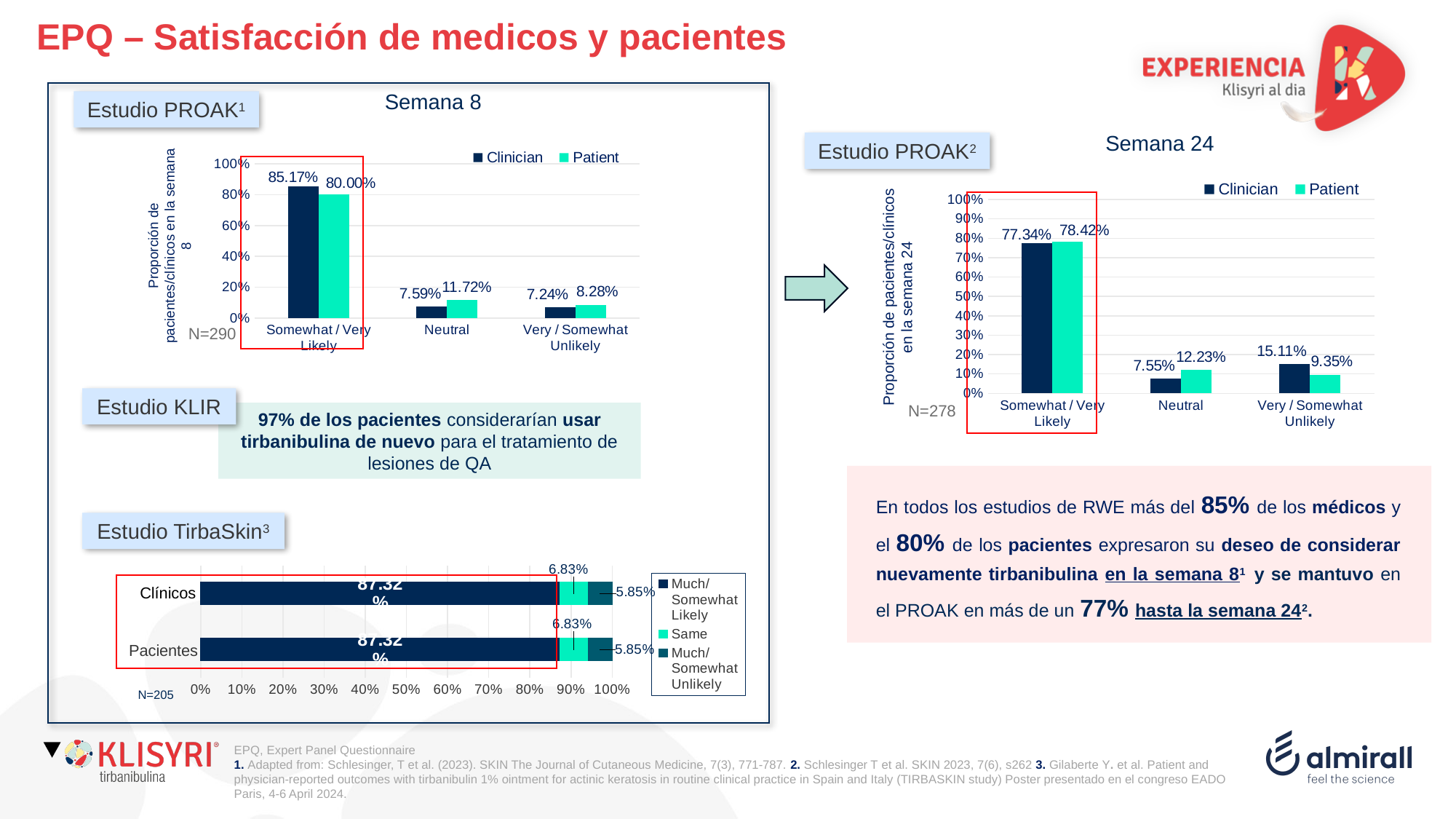
In the Semana 8 chart, what is the difference between the Clinician and Patient values for Somewhat / Very Likely? 5.17% In the Semana 24 chart, what is the Clinician value for Very / Somewhat Unlikely? 15.11% What kind of chart is the Estudio TirbaSkin chart? Stacked bar chart In the Estudio TirbaSkin chart, what is the total of the Pacientes bar? 100.00% In the Semana 24 chart, what is the Patient value for Somewhat / Very Likely? 78.42% In the Semana 24 chart, which is larger for Neutral, the Clinician value or the Patient value? Patient In the Semana 8 chart, how many series does the legend list? 2 In the Semana 8 chart, what is the Patient value for Neutral? 11.72% In the Semana 24 chart, which category has the highest Clinician value? Somewhat / Very Likely In the Estudio TirbaSkin chart, what is the Much/Somewhat Likely value for Clínicos? 87.32% In the Semana 8 chart, how many categories are shown on the x axis? 3 In the Semana 8 chart, what is the Clinician value for Somewhat / Very Likely? 85.17%